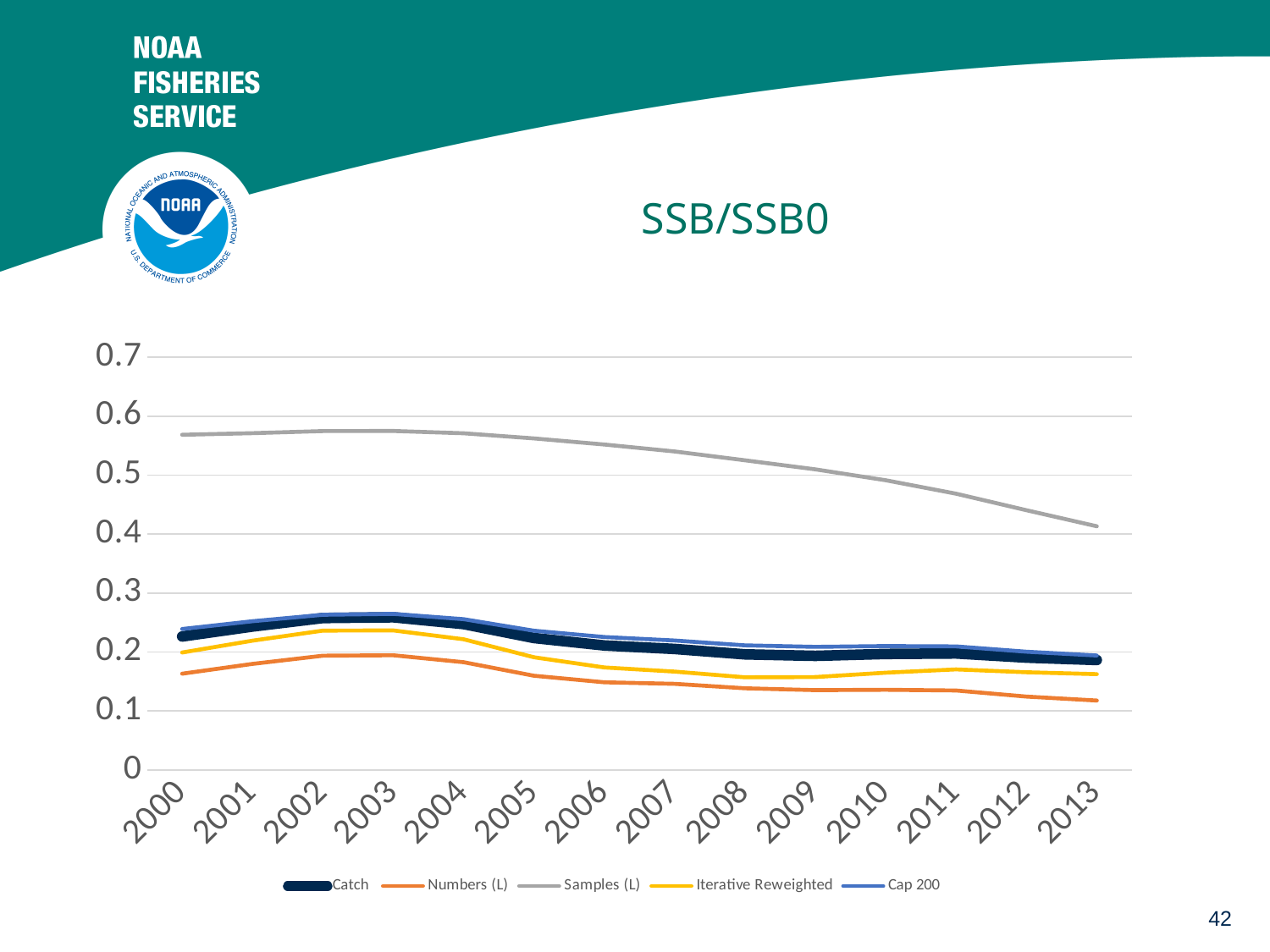
What kind of chart is shown on the slide? line chart Is the value for Catch in 2003 greater or less than 0.3? less What is the title of the chart? SSB/SSB0 How many years are shown along the x axis? 14 In 2008, which is larger: Samples (L) or Catch? Samples (L) Is the value for Samples (L) in 2000 greater or less than 0.5? greater Does the Samples (L) series rise or fall from 2005 to 2013? fall Which series has the highest values across all years? Samples (L) Which series has the lowest values across all years? Numbers (L) Is the value for Numbers (L) in 2013 greater or less than 0.2? less How many series does the legend list? 5